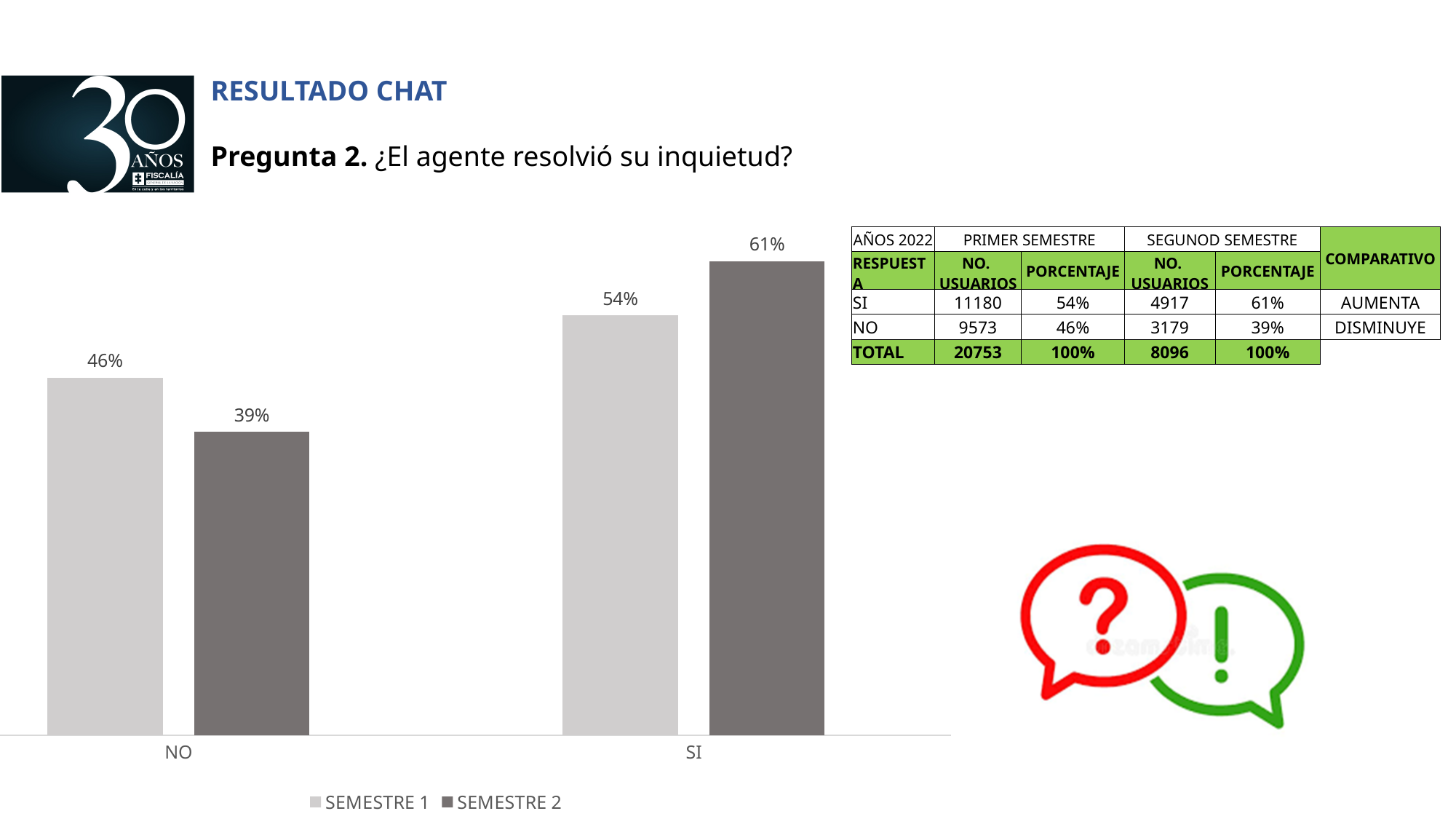
What is the difference between the SEMESTRE 2 and SEMESTRE 1 values for SI? 7% Which is larger for NO: the SEMESTRE 1 value or the SEMESTRE 2 value? SEMESTRE 1 What kind of chart is shown on the slide? Bar chart What is the value for SI in the SEMESTRE 1 series? 54% What is the value for NO in the SEMESTRE 2 series? 39% Which category has the lowest value in the SEMESTRE 2 series? NO How many series does the chart legend list? 2 What is the value for SI in the SEMESTRE 2 series? 61% What is the value for NO in the SEMESTRE 1 series? 46% How many categories are shown on the x axis of the chart? 2 What is the difference between the SEMESTRE 1 and SEMESTRE 2 values for NO? 7% Which category has the highest value in the SEMESTRE 2 series? SI